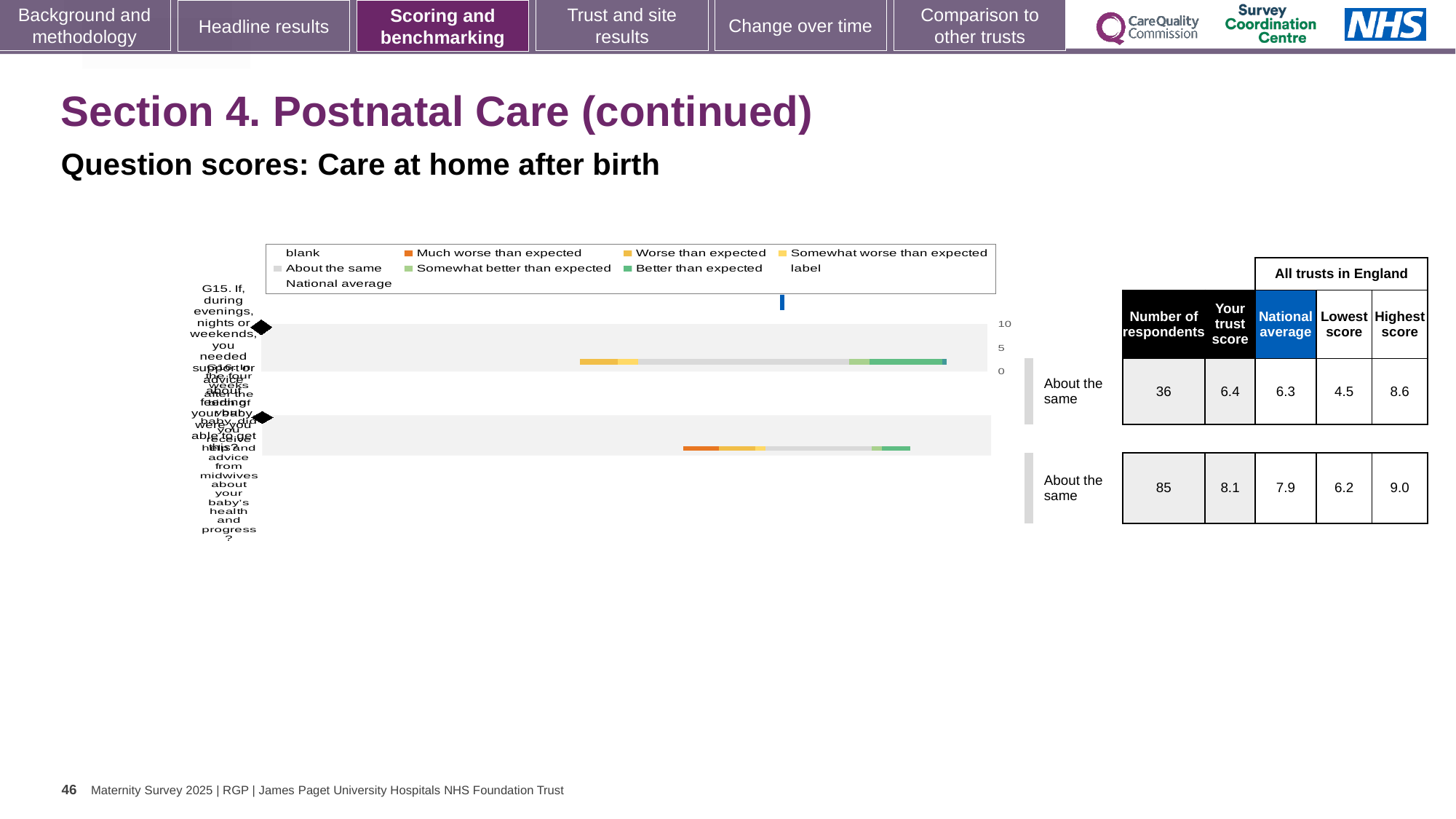
In the table next to the chart, what is the lowest score for the top row (G15)? 4.5 In the table next to the chart, what is the national average for the top row (G15)? 6.3 What benchmark category is shown beside the chart for both G15 and G16? About the same What kind of chart is shown on the slide? bar chart In the table next to the chart, what is the highest score for the bottom row (G16)? 9.0 What is the difference between the highest score (8.6) and the lowest score (4.5) for G15? 4.1 By how much does the trust score for G16 (8.1) exceed its national average (7.9)? 0.2 How many survey questions (rows) are plotted in the chart? 2 In the table next to the chart, what is the number of respondents for the top row (G15, support or advice about feeding your baby)? 36 In the table next to the chart, what is the trust score for the bottom row (G16, help and advice from midwives about your baby's health and progress)? 8.1 In the chart legend, what colour represents 'Much worse than expected'? orange Which row has the higher trust score, G15 or G16? G16